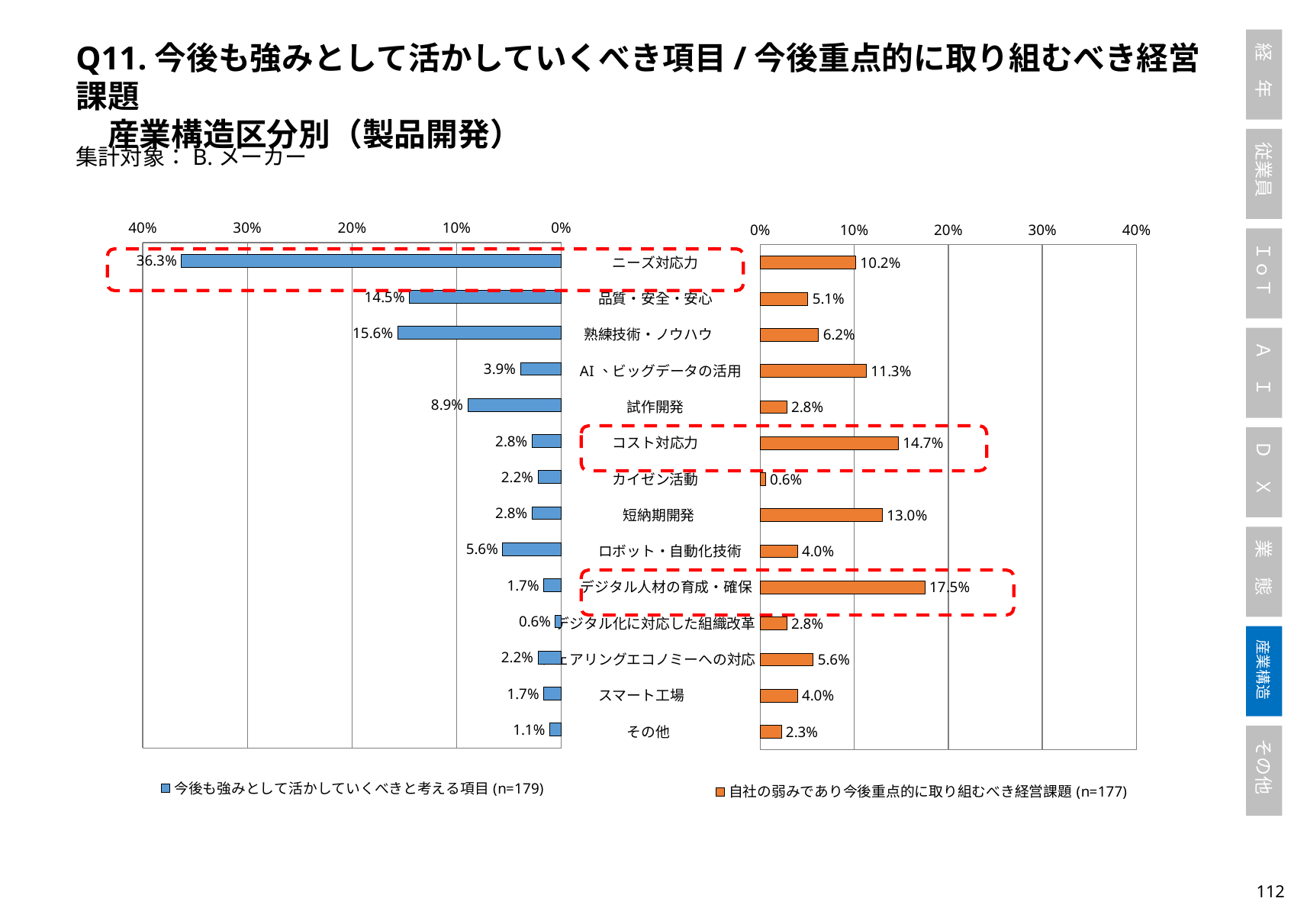
In the right chart, which category has the lowest value? カイゼン活動 In the right chart, which is larger: 短納期開発 or AI、ビッグデータの活用? 短納期開発 In the right chart, what is the value for コスト対応力? 14.7% In the left chart, is the value for 試作開発 greater or less than 10%? less What type of chart is the left chart? bar chart In the right chart (自社の弱みであり今後重点的に取り組むべき経営課題), what is the value for デジタル人材の育成・確保? 17.5% In the left chart (今後も強みとして活かしていくべきと考える項目), what is the value for ニーズ対応力? 36.3% In the right chart, which category has the highest value? デジタル人材の育成・確保 In the left chart, what is the difference between 熟練技術・ノウハウ and 品質・安全・安心? 1.1% How many categories are shown in the right chart? 14 What is the sample size (n) shown in the legend of the right chart? n=177 In the left chart, which category has the highest value? ニーズ対応力